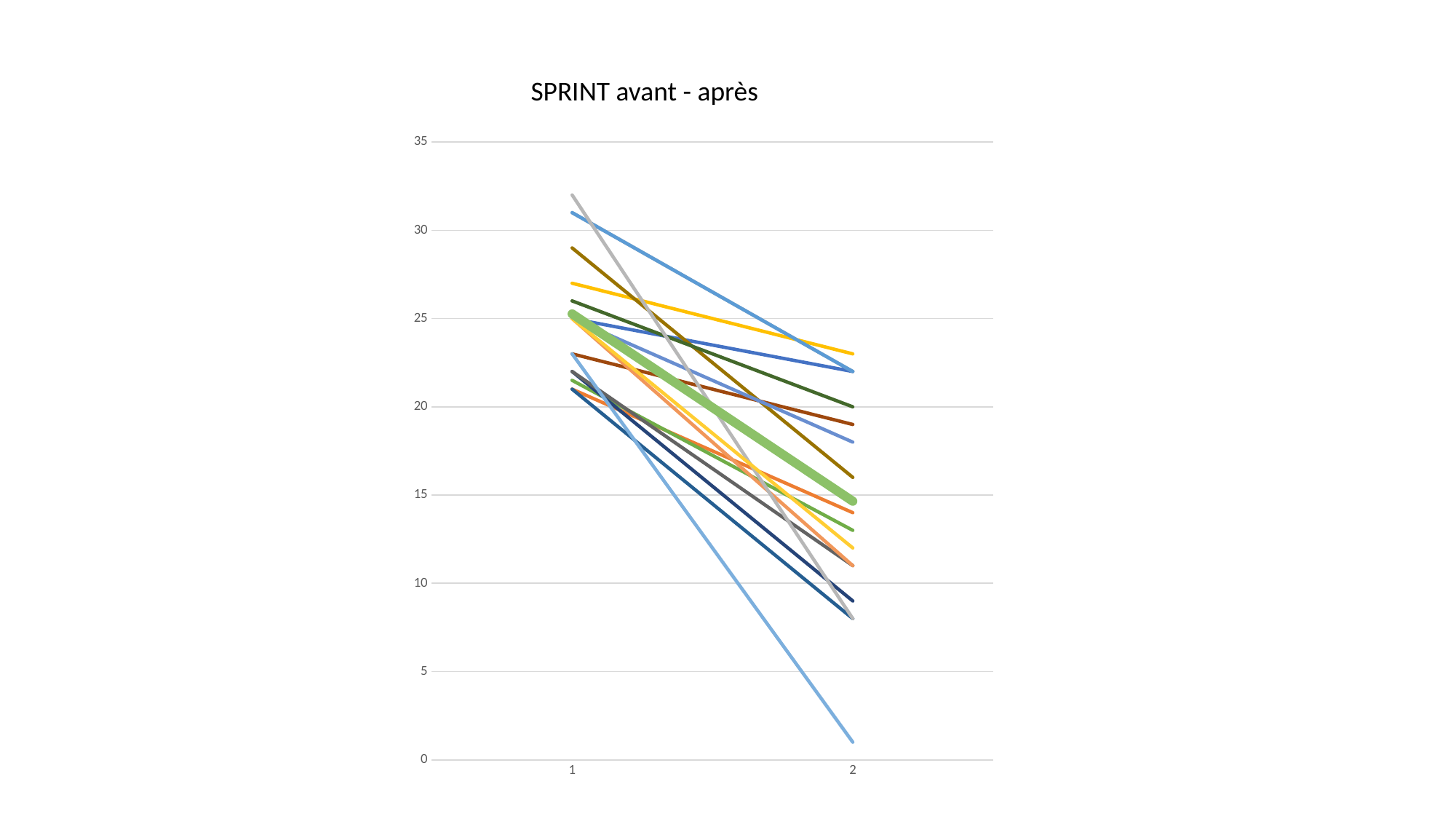
Is the highest value at point 2 greater or less than 25? less Does any line in the chart rise from point 1 to point 2? No How many points are there along the x axis of the chart? 2 What kind of chart is shown on the slide? Line chart Is the highest value at point 1 greater or less than 30? greater Is the lowest value at point 2 greater or less than 5? less What is the highest value shown on the y axis of the chart? 35 What is the title of the chart? SPRINT avant - après What are the labels on the x axis of the chart? 1 and 2 Do the lines in the chart generally rise or fall from point 1 to point 2? Fall